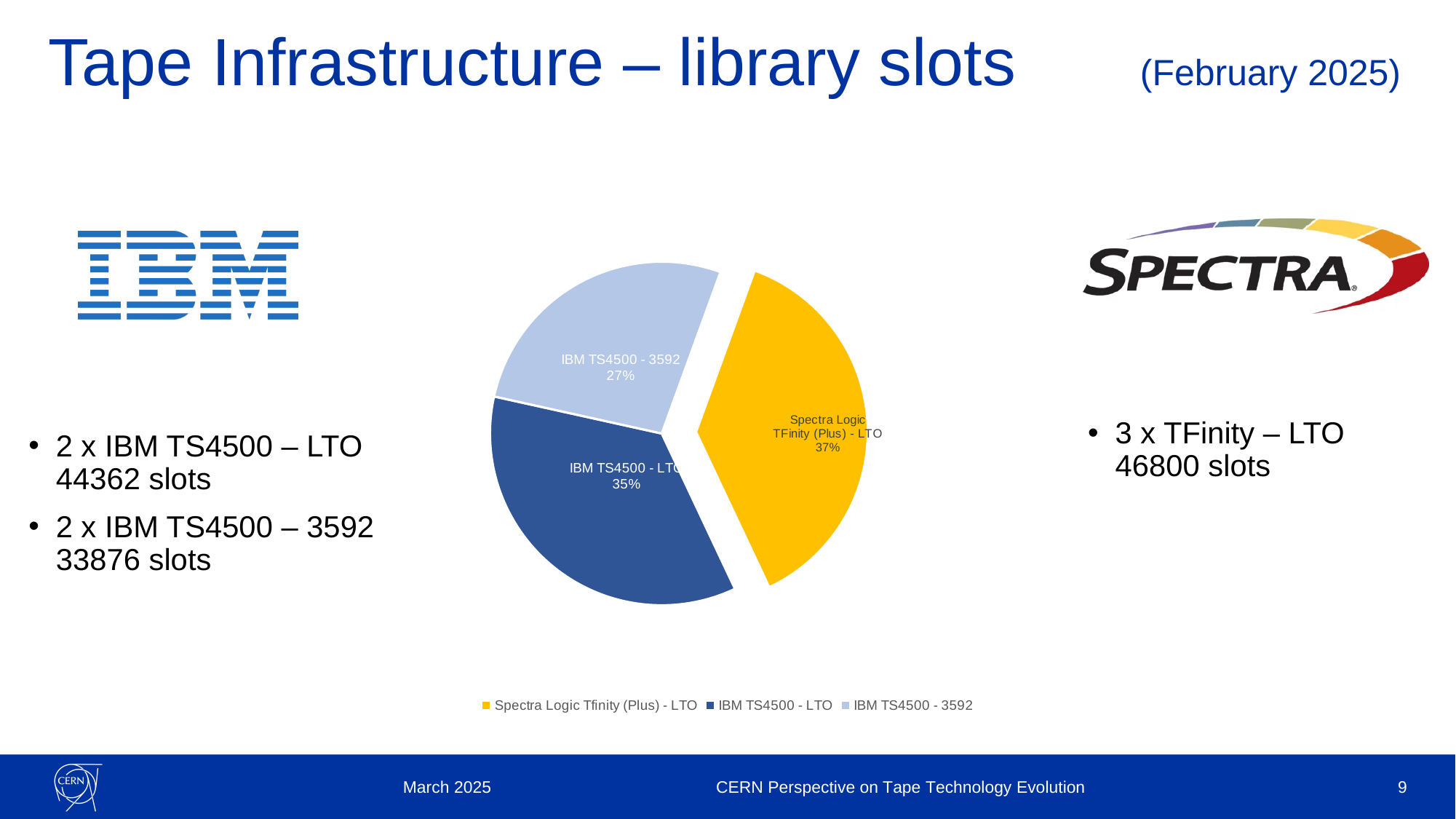
What type of chart is shown on the slide? pie chart What share of the pie does Spectra Logic TFinity (Plus) - LTO have? 37% How many entries does the legend list? 3 How many slices does the pie chart have? 3 What share of the pie does IBM TS4500 - LTO have? 35% What is the difference in percentage points between the Spectra Logic TFinity (Plus) - LTO slice and the IBM TS4500 - 3592 slice? 10 Which slice is pulled out (exploded) from the pie? Spectra Logic TFinity (Plus) - LTO What colour is the Spectra Logic TFinity (Plus) - LTO slice? yellow Which is larger, the IBM TS4500 - LTO slice or the IBM TS4500 - 3592 slice? IBM TS4500 - LTO What share of the pie does IBM TS4500 - 3592 have? 27% Which slice of the pie is the smallest? IBM TS4500 - 3592 Which slice of the pie is the largest? Spectra Logic TFinity (Plus) - LTO